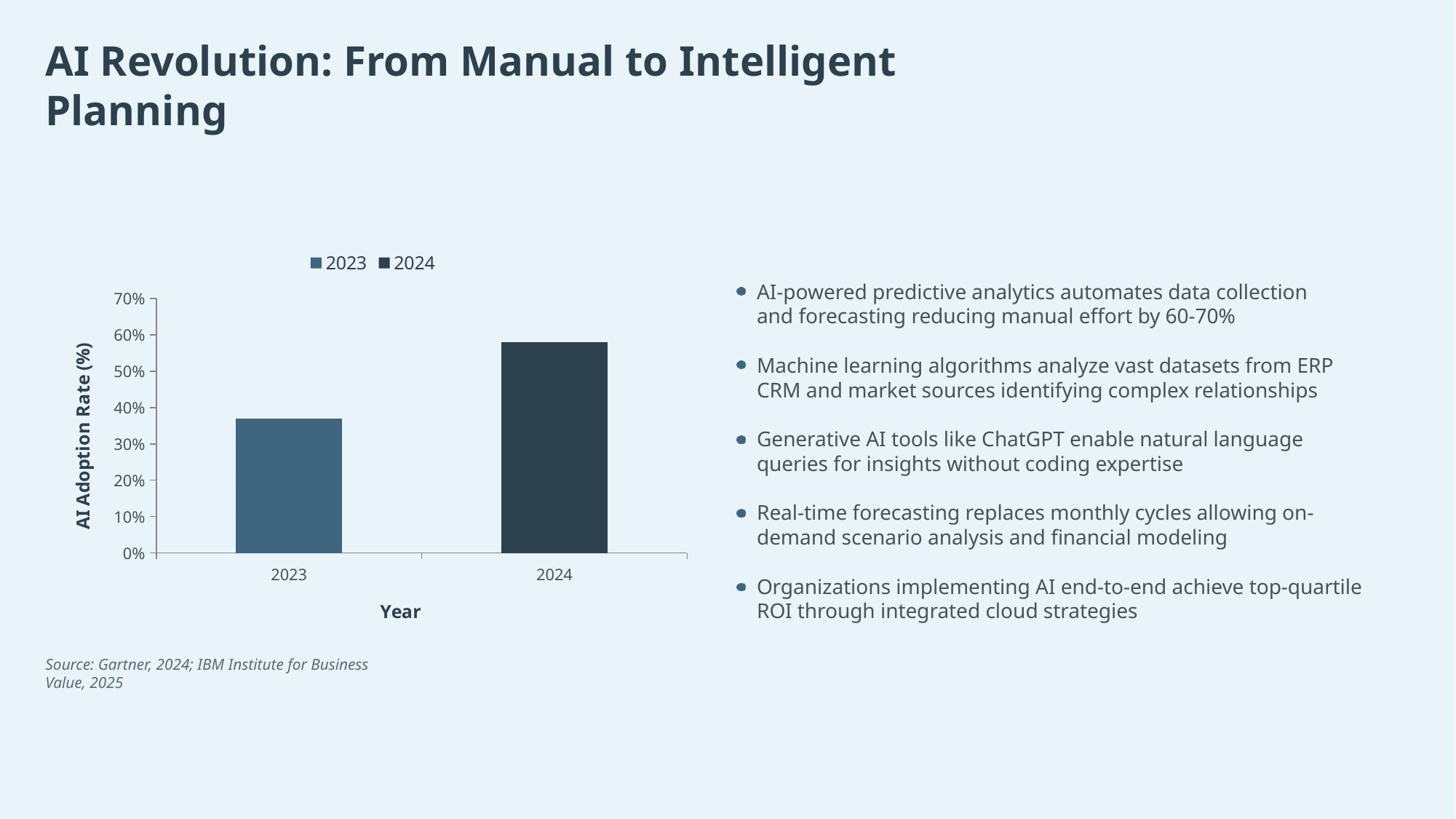
Which is larger, the AI adoption rate for 2023 or for 2024? 2024 Which year has the lowest AI adoption rate in the chart? 2023 What kind of chart is shown on the slide? bar chart Is the AI adoption rate for 2023 greater or less than 30%? greater Does the AI adoption rate rise or fall from 2023 to 2024? rise Which year has the highest AI adoption rate in the chart? 2024 What entries does the chart legend list? 2023 and 2024 What is the label on the vertical axis of the chart? AI Adoption Rate (%) How many bars are plotted in the chart? 2 How many series does the chart legend list? 2 Is the AI adoption rate for 2024 greater or less than 50%? greater Is the AI adoption rate for 2023 greater or less than 40%? less